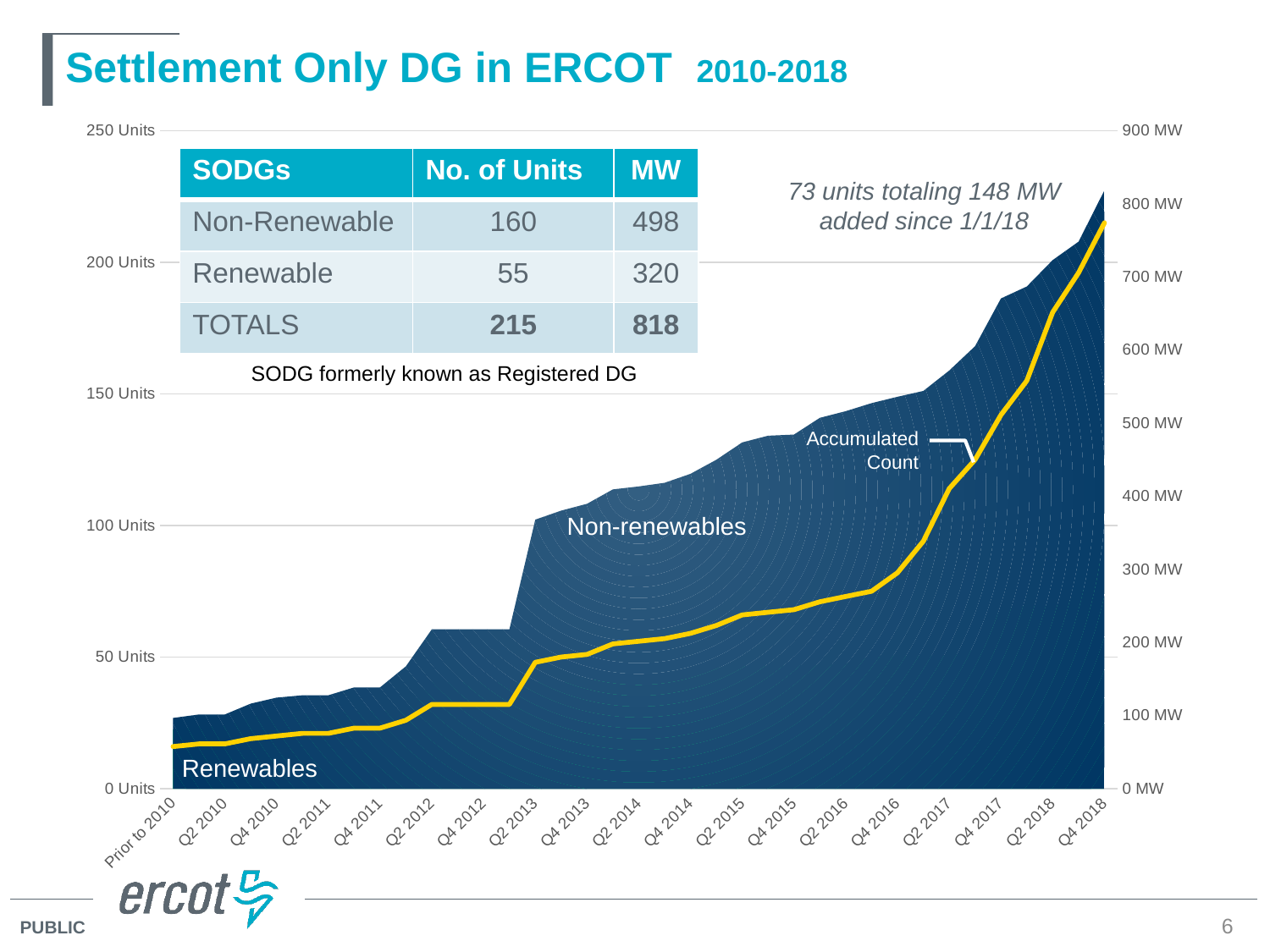
Is the Accumulated Count at Q2 2012 greater or less than 50 Units? less Does the Accumulated Count line rise or fall from Prior to 2010 to Q4 2018? Rises What is the highest tick shown on the right-hand MW axis? 900 MW How many series are labelled on the chart? 3 What kind of chart is shown on the slide? Area chart with a line According to the table, what is the total MW of SODGs? 818 Is the Accumulated Count at Q4 2016 greater or less than 100 Units? less According to the table, how many Renewable units are there? 55 Which area series is stacked on top of the other: Renewables or Non-renewables? Non-renewables Is the top of the stacked area at Q2 2013 greater or less than 300 MW? greater